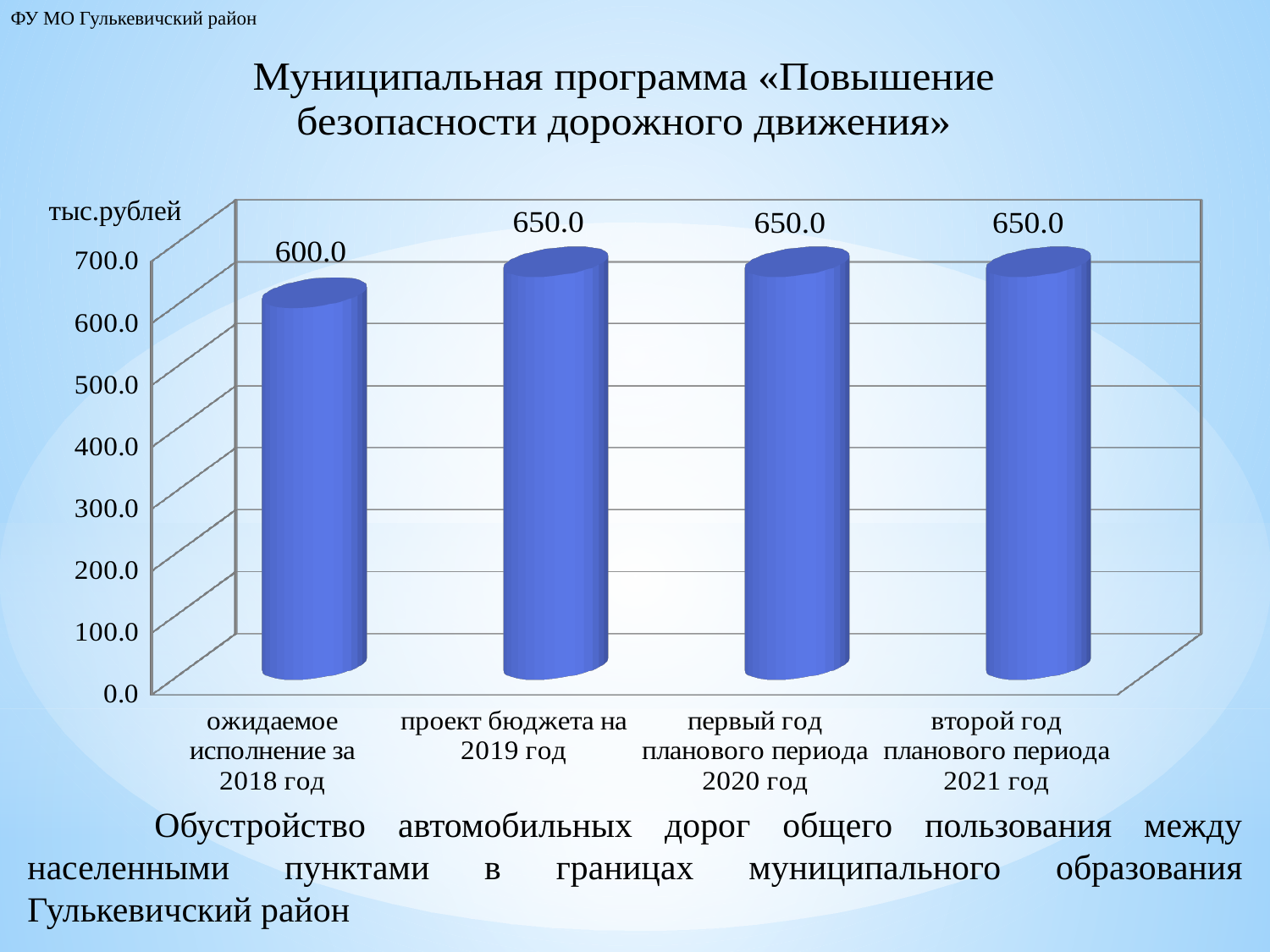
Do the values rise or fall from 2018 to 2019? rise Is the value for "ожидаемое исполнение за 2018 год" greater or less than 500.0? greater What unit is indicated on the chart's vertical axis? тыс.рублей What kind of chart is shown on the slide? bar chart What is the value for "первый год планового периода 2020 год"? 650.0 Which category has the lowest value? ожидаемое исполнение за 2018 год What is the difference between the value for "проект бюджета на 2019 год" and the value for "ожидаемое исполнение за 2018 год"? 50.0 What is the value for "проект бюджета на 2019 год"? 650.0 How many categories are shown on the chart? 4 What is the value for "ожидаемое исполнение за 2018 год"? 600.0 Which is larger: the value for "ожидаемое исполнение за 2018 год" or the value for "проект бюджета на 2019 год"? проект бюджета на 2019 год What is the value for "второй год планового периода 2021 год"? 650.0